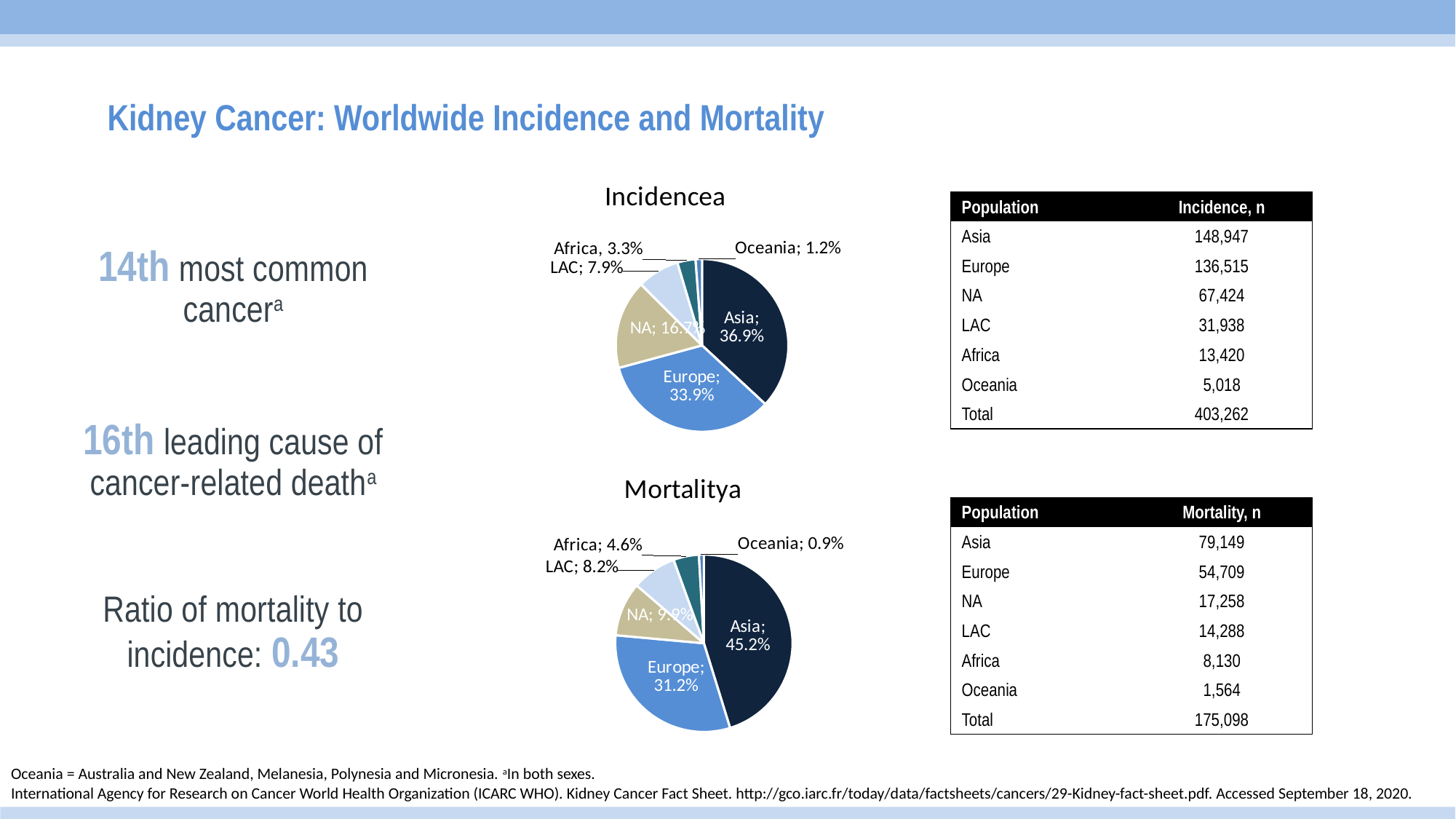
In the Incidence pie chart, what share does Europe have? 33.9% How many slices does the Mortality pie chart have? 6 In the Incidence pie chart, what is the difference between the Asia and Europe shares? 3.0% What type of chart is used for the Incidence chart? pie chart In the Mortality pie chart, what is the difference between the Europe and NA shares? 21.3% In the Incidence pie chart, what share does Asia have? 36.9% In the Incidence pie chart, what share does LAC have? 7.9% In the Mortality pie chart, what share does Asia have? 45.2% In the Mortality pie chart, which region has the largest slice? Asia In the Incidence pie chart, which region has the smallest slice? Oceania In the Mortality pie chart, what share does Africa have? 4.6% In the Mortality pie chart, which is larger, the LAC slice or the Africa slice? LAC